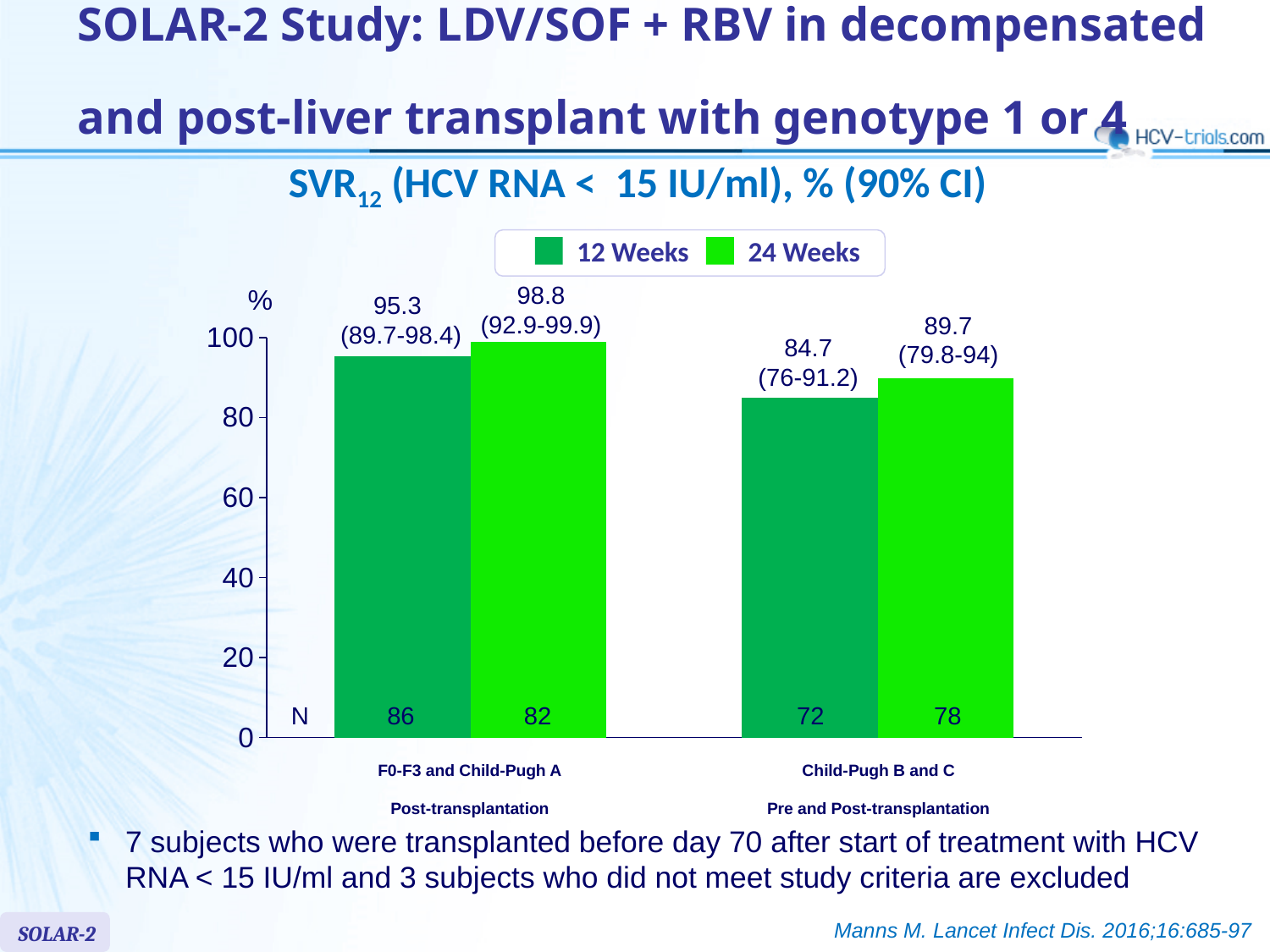
Which is larger: the 12 Weeks value for F0-F3 and Child-Pugh A or the 24 Weeks value for Child-Pugh B and C? 12 Weeks value for F0-F3 and Child-Pugh A Which bar has the highest SVR12 value? 24 Weeks, F0-F3 and Child-Pugh A What is the SVR12 value for the 24 Weeks series in the Child-Pugh B and C group? 89.7 What is the SVR12 value for the 12 Weeks series in the F0-F3 and Child-Pugh A group? 95.3 Which bar has the lowest SVR12 value? 12 Weeks, Child-Pugh B and C What kind of chart is shown on the slide? Bar chart What is the N for the 12 Weeks bar in the Child-Pugh B and C group? 72 What are the two series named in the legend? 12 Weeks and 24 Weeks What is the 90% CI shown for the 24 Weeks bar in the F0-F3 and Child-Pugh A group? (92.9-99.9) How many patient groups are shown on the x axis? 2 How many series does the legend list? 2 What is the difference between the 24 Weeks and 12 Weeks SVR12 values in the Child-Pugh B and C group? 5.0